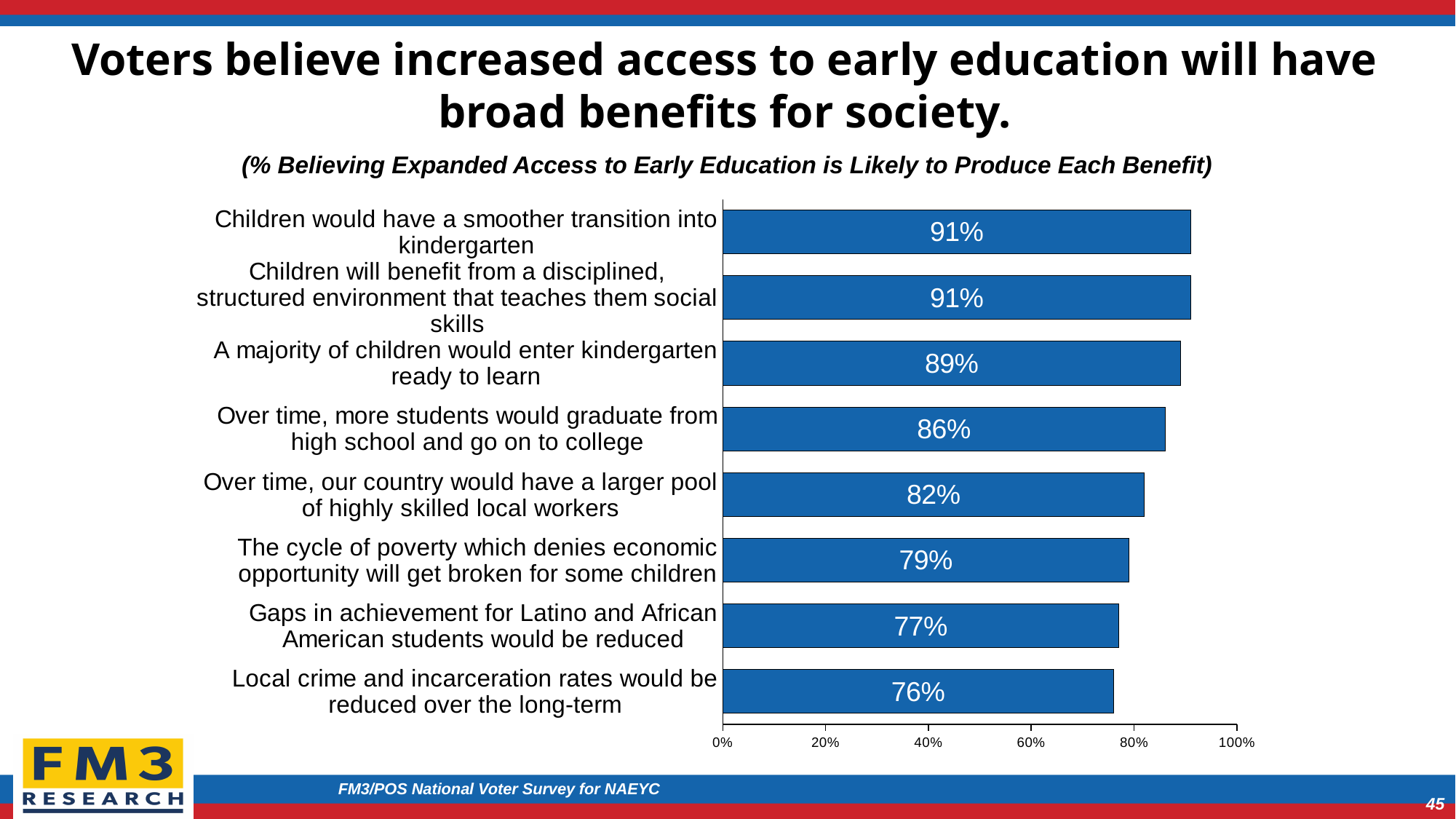
What percentage of voters believe local crime and incarceration rates would be reduced over the long-term? 76% What percentage of voters believe children would have a smoother transition into kindergarten? 91% Is the value for 'The cycle of poverty which denies economic opportunity will get broken for some children' greater or less than 80%? less Which is larger: the percentage for 'Over time, more students would graduate from high school and go on to college' or for 'Gaps in achievement for Latino and African American students would be reduced'? Over time, more students would graduate from high school and go on to college Which benefit has the lowest percentage of voters believing it is likely? Local crime and incarceration rates would be reduced over the long-term What is the difference between the percentage for 'A majority of children would enter kindergarten ready to learn' and 'The cycle of poverty which denies economic opportunity will get broken for some children'? 10% What is the highest value shown on the x axis? 100% What is the subtitle of the chart? (% Believing Expanded Access to Early Education is Likely to Produce Each Benefit) What percentage of voters believe gaps in achievement for Latino and African American students would be reduced? 77% How many benefits are shown in the chart? 8 What kind of chart is shown on the slide? Bar chart What percentage of voters believe that over time, our country would have a larger pool of highly skilled local workers? 82%